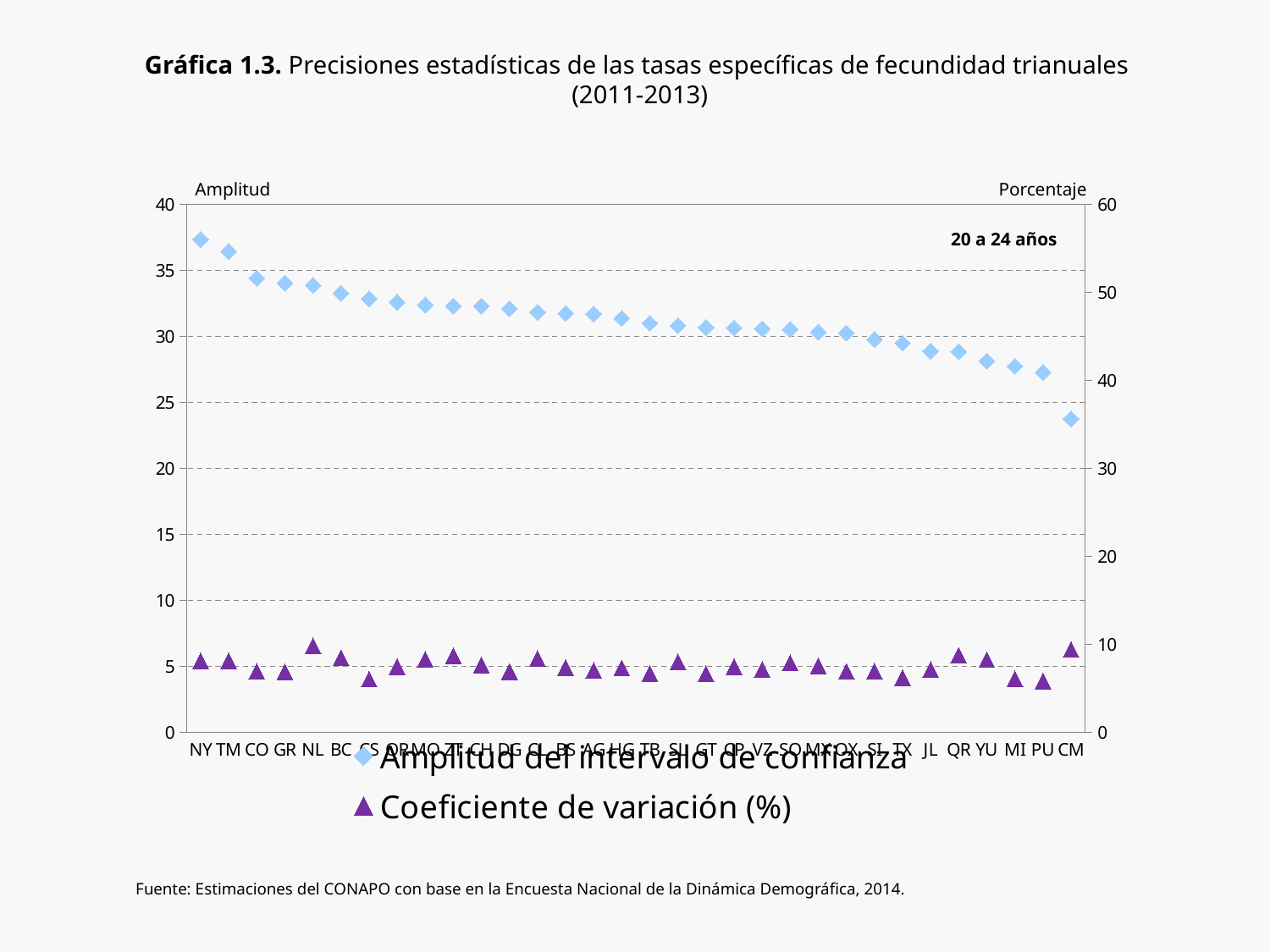
Which age group is indicated in the label inside the plot area? 20 a 24 años Which category has the lowest value for Amplitud del intervalo de confianza? CM How many series does the legend list? 2 Do the values for Amplitud del intervalo de confianza rise or fall from NY to CM along the x axis? fall What is the label of the right-hand vertical axis? Porcentaje Which has a larger Amplitud del intervalo de confianza value, TM or PU? TM Is the Amplitud del intervalo de confianza value for CM greater or less than 25 on the left axis? less Which category has the highest value for Amplitud del intervalo de confianza? NY Is the Amplitud del intervalo de confianza value for CO greater or less than 35 on the left axis? less Which series is shown with purple triangle markers? Coeficiente de variación (%) Which has a larger Amplitud del intervalo de confianza value, CM or NL? NL Is the Amplitud del intervalo de confianza value for NY greater or less than 35 on the left axis? greater